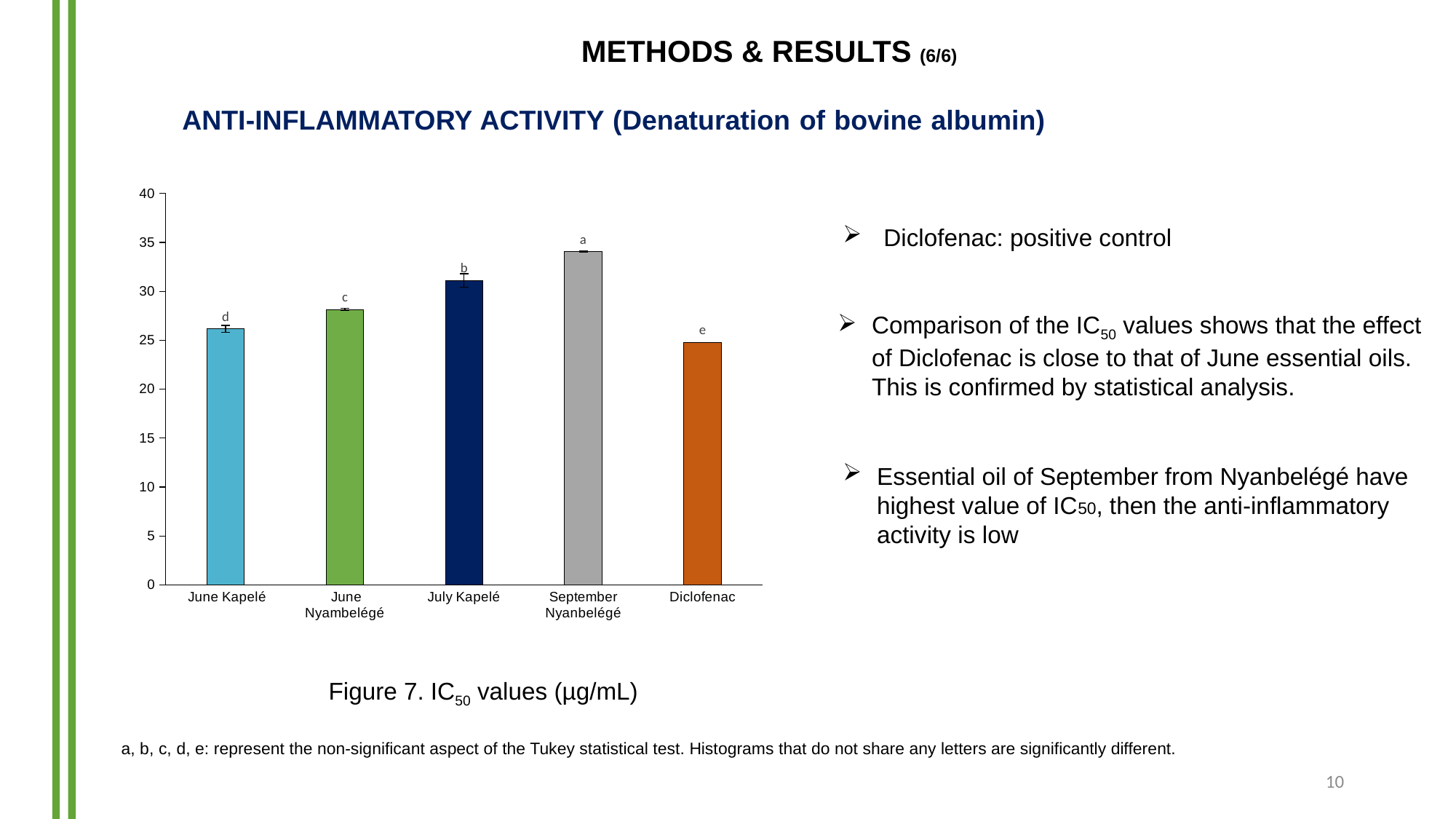
Which category has the highest IC50 value in the chart? September Nyanbelégé How many bars (categories) are plotted in the chart? 5 Which has a larger IC50 value, June Nyambelégé or Diclofenac? June Nyambelégé Which letter from the Tukey test is shown above the Diclofenac bar? e Is the value for September Nyanbelégé greater or less than 30? greater What kind of chart is shown on the slide? bar chart Which has a larger IC50 value, July Kapelé or June Kapelé? July Kapelé Is the value for July Kapelé greater or less than 35? less What is the caption of the figure below the chart? Figure 7. IC50 values (µg/mL) Is the value for June Kapelé greater or less than 25? greater Which category has the lowest IC50 value in the chart? Diclofenac